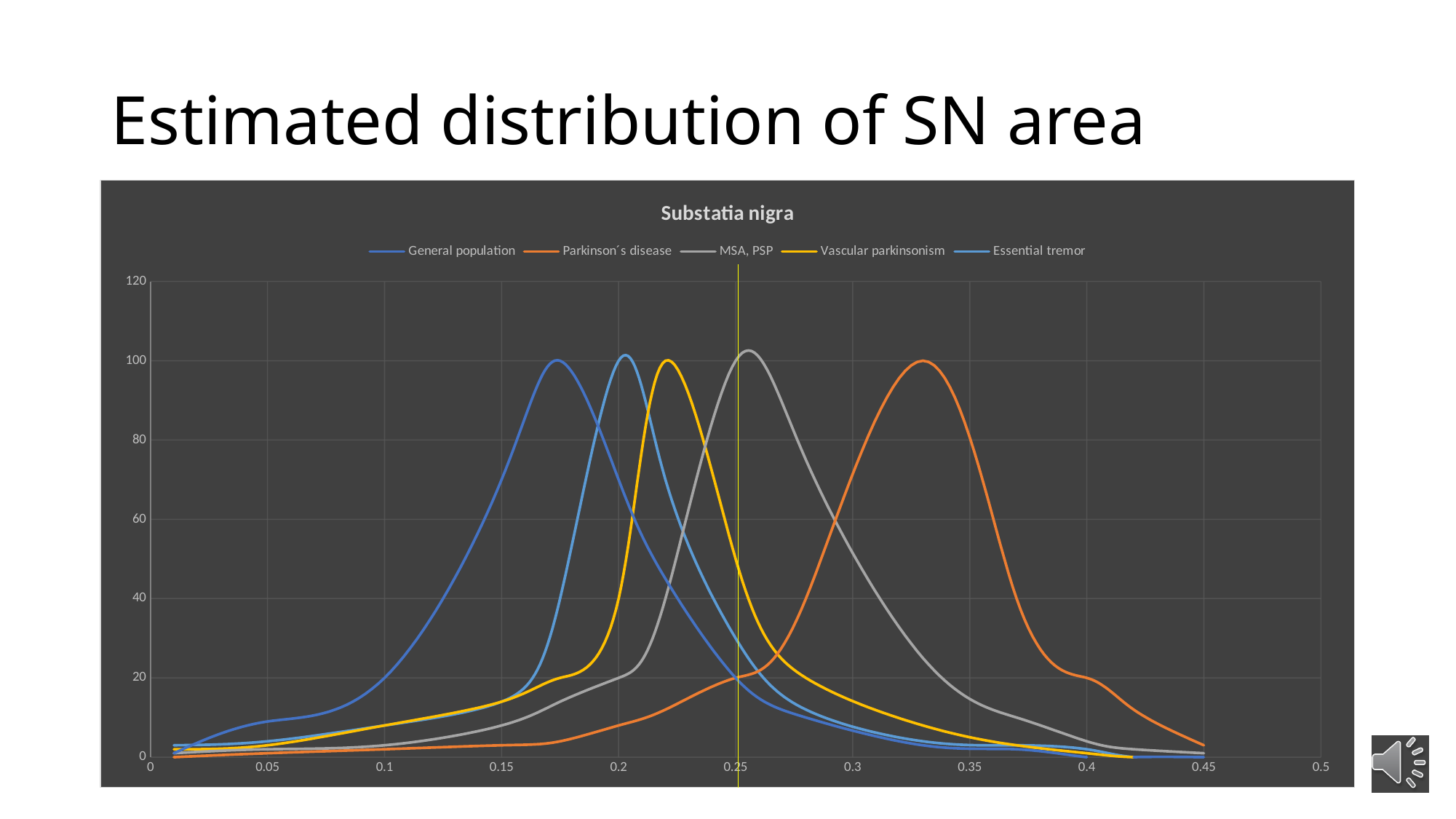
What is the highest value shown on the y axis of the chart? 120 What is the title of the chart? Substatia nigra Is the value for MSA, PSP at x = 0.35 greater or less than 20? less How many series does the legend of the chart list? 5 Which series has its peak furthest to the left along the x axis? General population What kind of chart is shown on the slide? line chart Is the value for Parkinson´s disease at x = 0.2 greater or less than 20? less Which series in the chart is drawn in orange? Parkinson´s disease Is the value for Vascular parkinsonism at x = 0.3 greater or less than 20? less Which series has its peak furthest to the right along the x axis? Parkinson´s disease